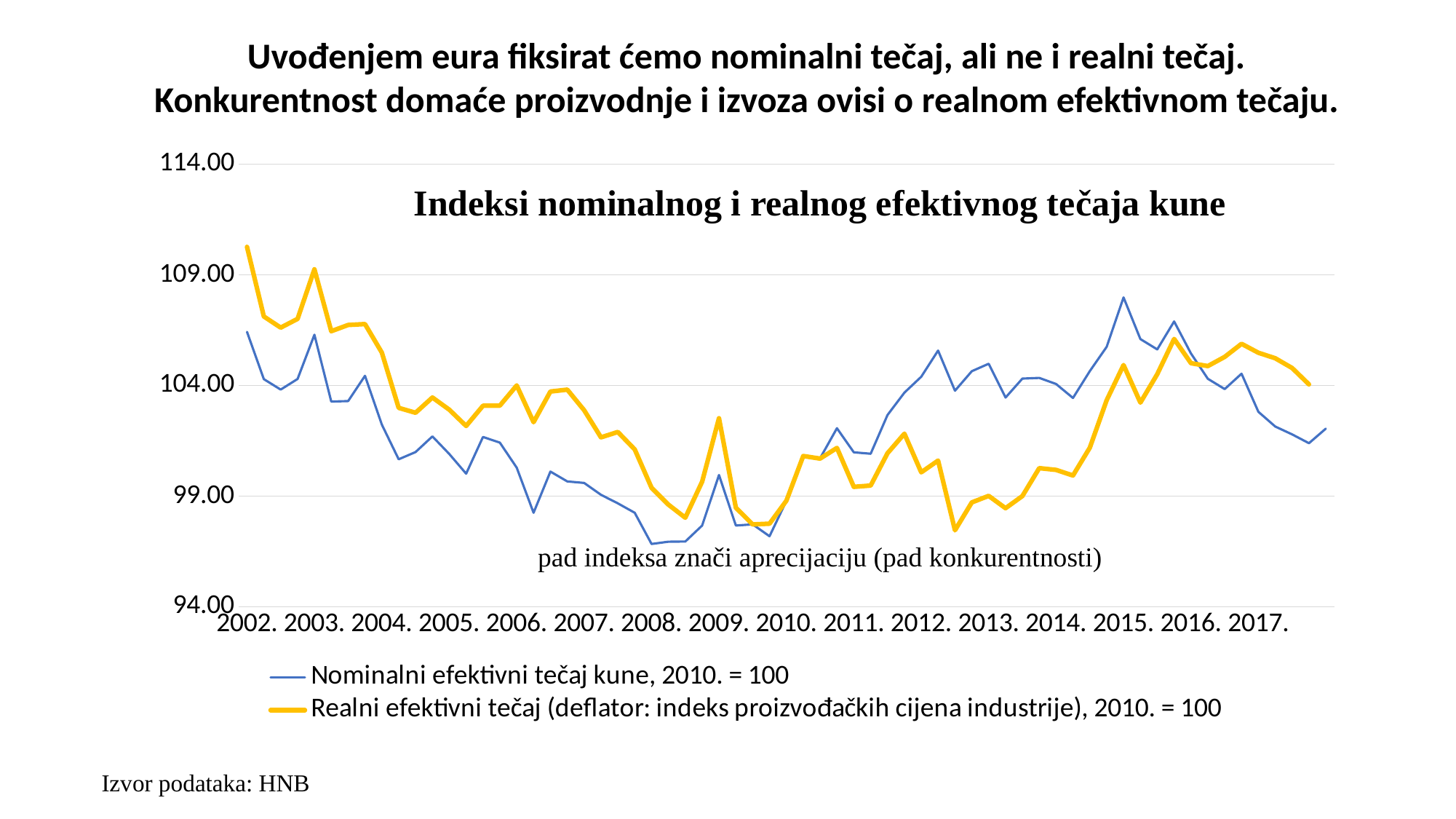
How many series does the legend list? 2 At the start of 2002, which series has the higher value, Nominalni efektivni tečaj or Realni efektivni tečaj? Realni efektivni tečaj Is the value of the Realni efektivni tečaj at the start of 2002 greater or less than 109? greater What is the title of the chart? Indeksi nominalnog i realnog efektivnog tečaja kune Is the lowest value of the Nominalni efektivni tečaj around 2008 greater or less than 99? less Is the lowest value of the Realni efektivni tečaj around 2013 greater or less than 99? less How many year labels are shown on the x axis? 16 Which series is drawn with the thick yellow line? Realni efektivni tečaj (deflator: indeks proizvođačkih cijena industrije), 2010. = 100 Do the values of the Realni efektivni tečaj rise or fall from 2002 to 2008? fall What kind of chart is shown on the slide? line chart